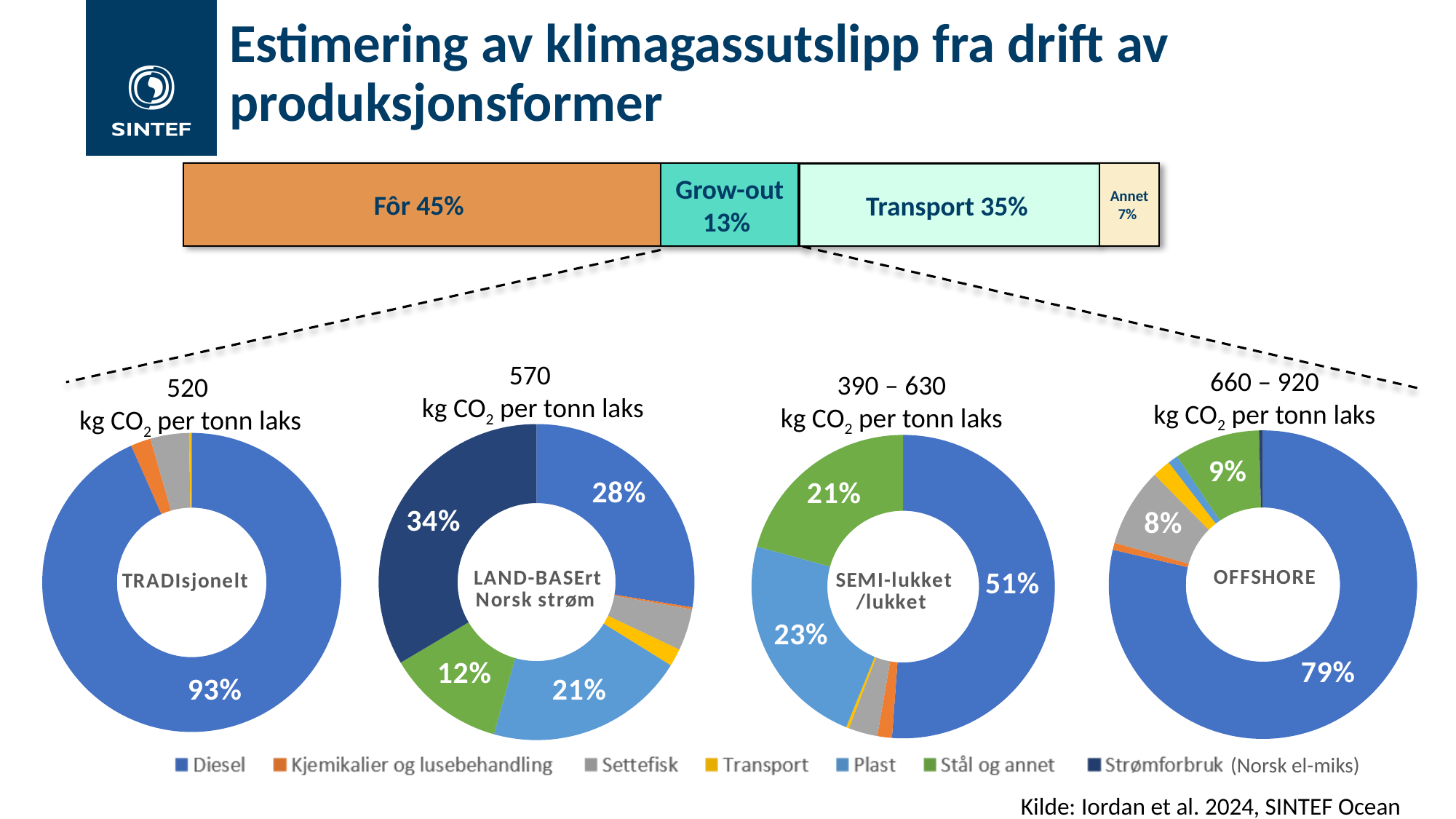
In the stacked bar at the top of the slide, what is the difference between the Fôr share and the Grow-out share? 32% In the stacked bar at the top of the slide, what share is labelled for Transport? 35% How many series does the legend below the donut charts list? 7 In the LAND-BASErt Norsk strøm donut chart, which labelled category has the smallest share? Stål og annet In the TRADIsjonelt donut chart, what share is labelled for Diesel? 93% In the OFFSHORE donut chart, what share is labelled for Settefisk? 8% In the LAND-BASErt Norsk strøm donut chart, what share is labelled for Strømforbruk (Norsk el-miks)? 34% In the LAND-BASErt Norsk strøm donut chart, which labelled category has the largest share? Strømforbruk (Norsk el-miks) In the SEMI-lukket/lukket donut chart, what is the difference between the Diesel share and the Plast share? 28% In the OFFSHORE donut chart, which is larger: the Stål og annet share or the Settefisk share? Stål og annet What kind of charts are the four charts in the lower part of the slide? Donut (pie) charts In the SEMI-lukket/lukket donut chart, what share is labelled for Plast? 23%